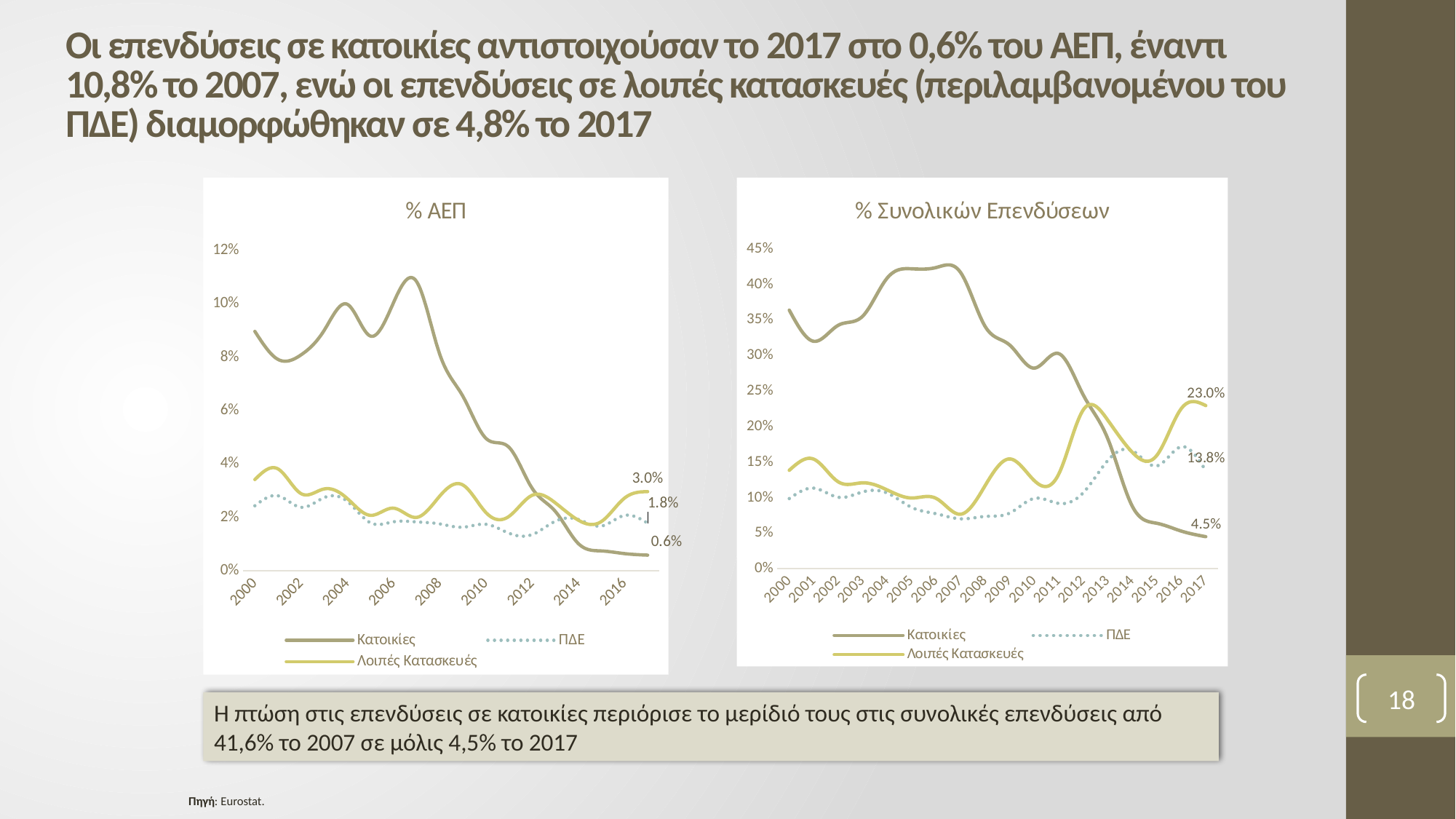
In the "% Συνολικών Επενδύσεων" chart, which series has the highest value in 2017? Λοιπές Κατασκευές In the "% Συνολικών Επενδύσεων" chart, what is the labelled value for Κατοικίες in 2017? 4.5% In the "% ΑΕΠ" chart, what is the labelled value for Κατοικίες at the end of the series (2017)? 0.6% In the "% ΑΕΠ" chart, is the value for Κατοικίες in 2007 greater or less than 10%? greater In the "% Συνολικών Επενδύσεων" chart, what is the difference between the 2017 values for Λοιπές Κατασκευές and Κατοικίες? 18.5% In the "% Συνολικών Επενδύσεων" chart, does the Κατοικίες series rise or fall between 2007 and 2017? fall In the "% Συνολικών Επενδύσεων" chart, what is the labelled value for Λοιπές Κατασκευές in 2017? 23.0% In the "% ΑΕΠ" chart, what is the labelled value for Λοιπές Κατασκευές at the end of the series (2017)? 3.0% How many series does the legend of the "% Συνολικών Επενδύσεων" chart list? 3 In the "% ΑΕΠ" chart, what is the labelled value for ΠΔΕ at the end of the series (2017)? 1.8% In the "% ΑΕΠ" chart, what is the difference between the 2017 values for Λοιπές Κατασκευές and Κατοικίες? 2.4% What kind of chart is the "% ΑΕΠ" chart on the left? line chart